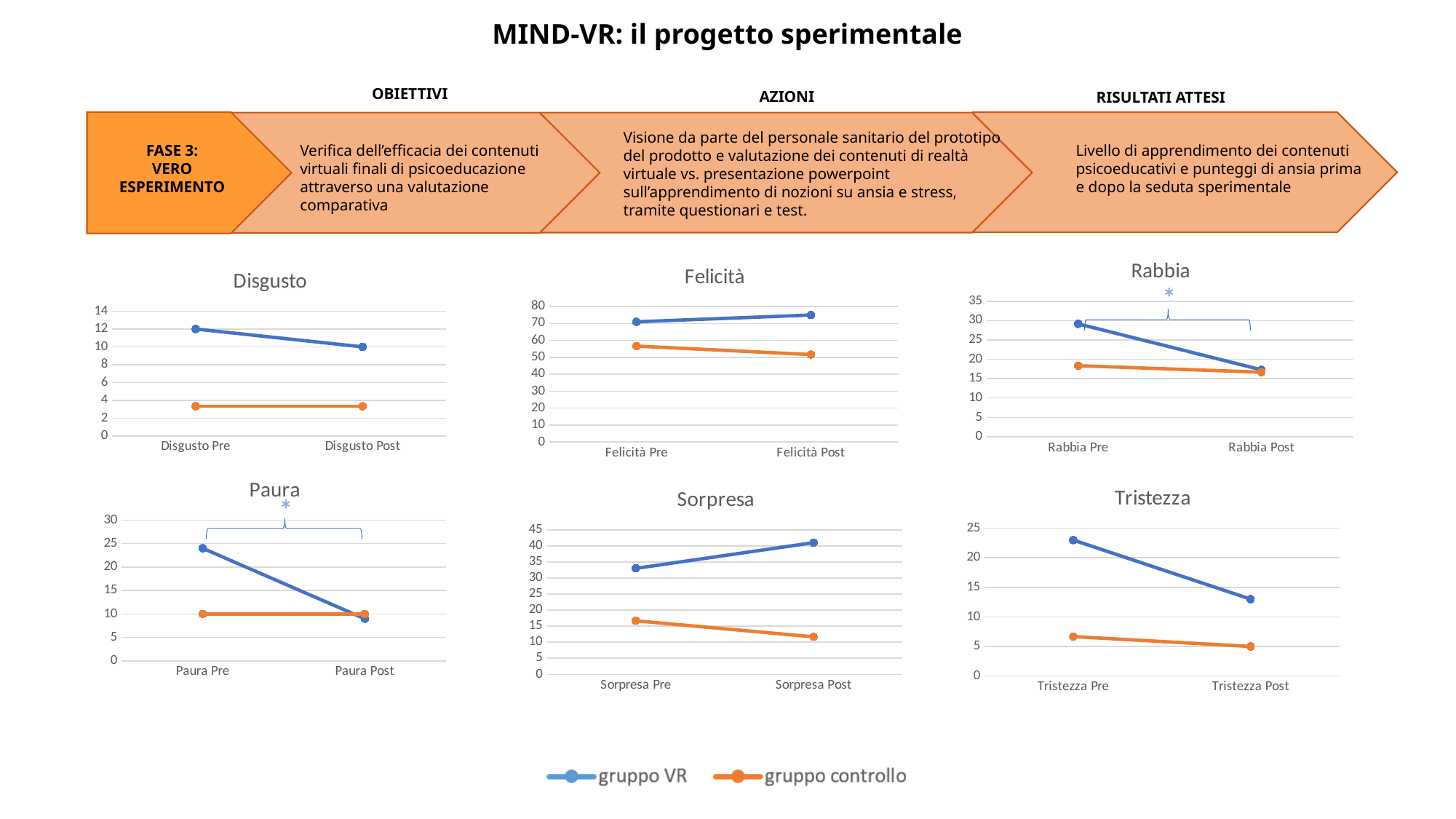
In the "Disgusto" chart, what is the value for gruppo VR at Disgusto Post? 10 In the "Felicità" chart, does the gruppo VR line rise or fall from Felicità Pre to Felicità Post? rise In the "Paura" chart, what is the value for gruppo controllo at Paura Pre? 10 In the "Tristezza" chart, does the gruppo VR line rise or fall from Tristezza Pre to Tristezza Post? fall How many series does the shared legend at the bottom of the slide list? 2 In the "Disgusto" chart, what is the value for gruppo VR at Disgusto Pre? 12 What kind of chart is the "Disgusto" chart? line chart In the "Felicità" chart, which series has the higher value at Felicità Pre, gruppo VR or gruppo controllo? gruppo VR In the "Rabbia" chart, is the value for gruppo VR at Rabbia Pre greater or less than 25? greater In the "Disgusto" chart, what is the difference between the gruppo VR values at Disgusto Pre and Disgusto Post? 2 How many charts are shown on the slide? 6